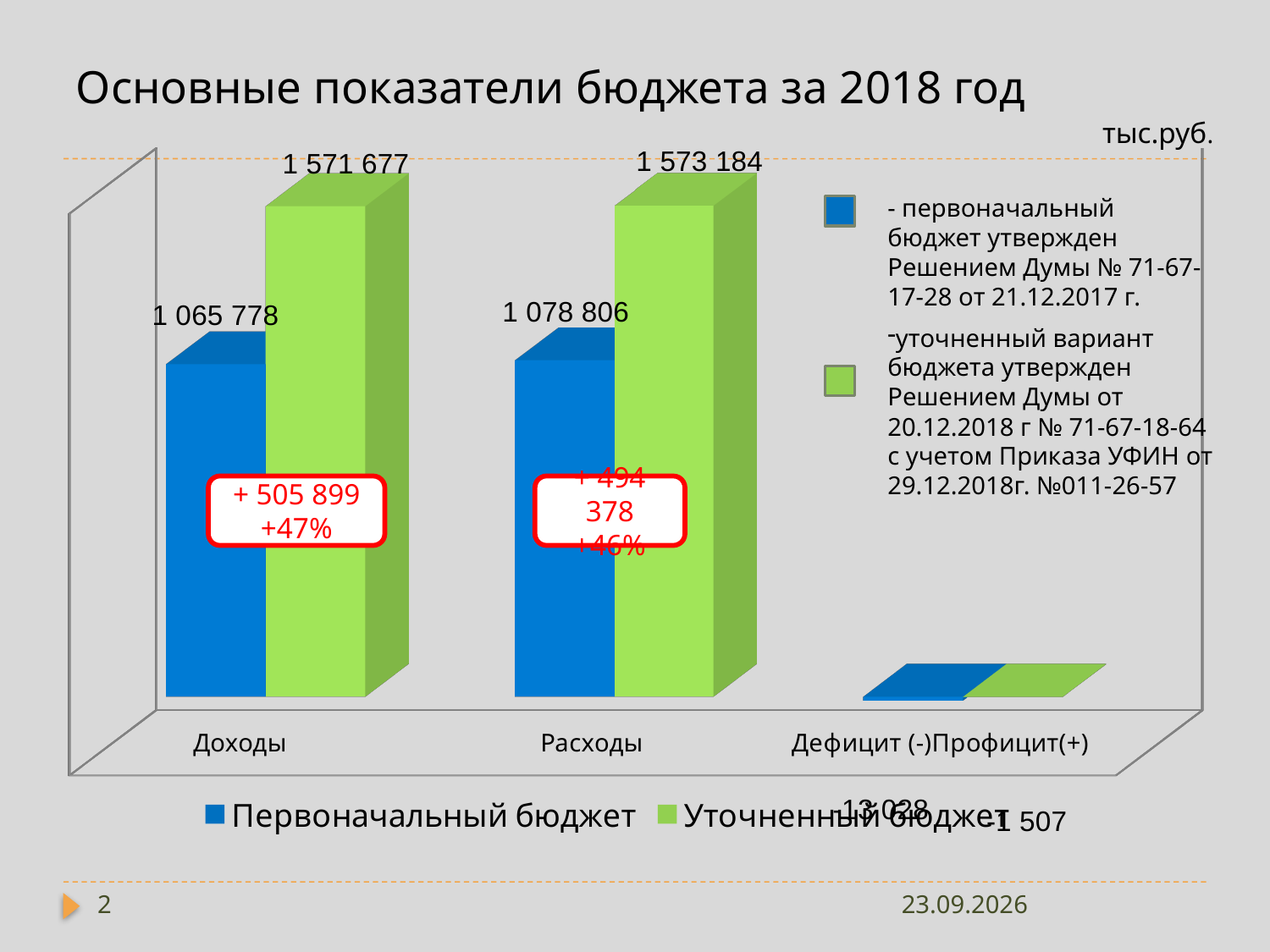
What is the value of Уточненный бюджет for Расходы? 1 573 184 What type of chart is shown on the slide? Bar chart What percentage increase is shown in the red box for Доходы? +47% What is the value of Первоначальный бюджет for Доходы? 1 065 778 By how much does Уточненный бюджет exceed Первоначальный бюджет for Доходы? 505 899 In what units are the chart values given, according to the label at the top right? тыс.руб. How many categories are shown on the x axis of the chart? 3 By how much does Уточненный бюджет exceed Первоначальный бюджет for Расходы? 494 378 What is the value of Первоначальный бюджет for Расходы? 1 078 806 What is the value of Уточненный бюджет for Доходы? 1 571 677 For Доходы, which series is larger: Первоначальный бюджет or Уточненный бюджет? Уточненный бюджет How many series does the chart legend list? 2